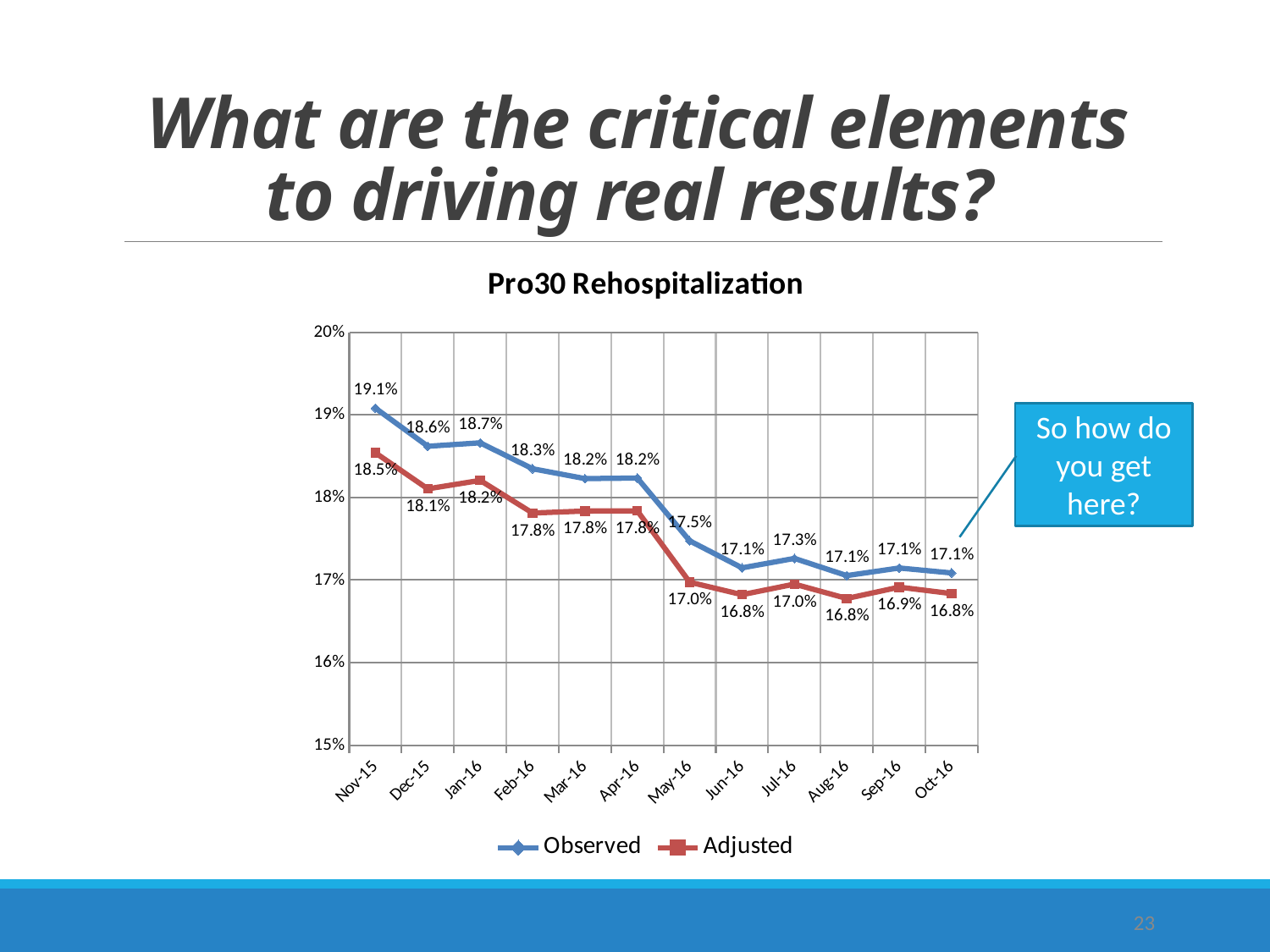
What is the Adjusted value for Oct-16? 16.8% What kind of chart is shown on the slide? line chart What is the Adjusted value for May-16? 17.0% Which is larger, the Observed value for Jun-16 or for Jul-16? Jul-16 What is the title of the chart? Pro30 Rehospitalization In which month is the Observed value highest? Nov-15 Do the Observed values generally rise or fall from Nov-15 to Oct-16? fall How many series does the legend list? 2 How many months are plotted along the x axis? 12 In which month is the Adjusted value highest? Nov-15 What is the difference between the Observed and Adjusted values in Nov-15? 0.6 percentage points What is the Observed value for Nov-15? 19.1%